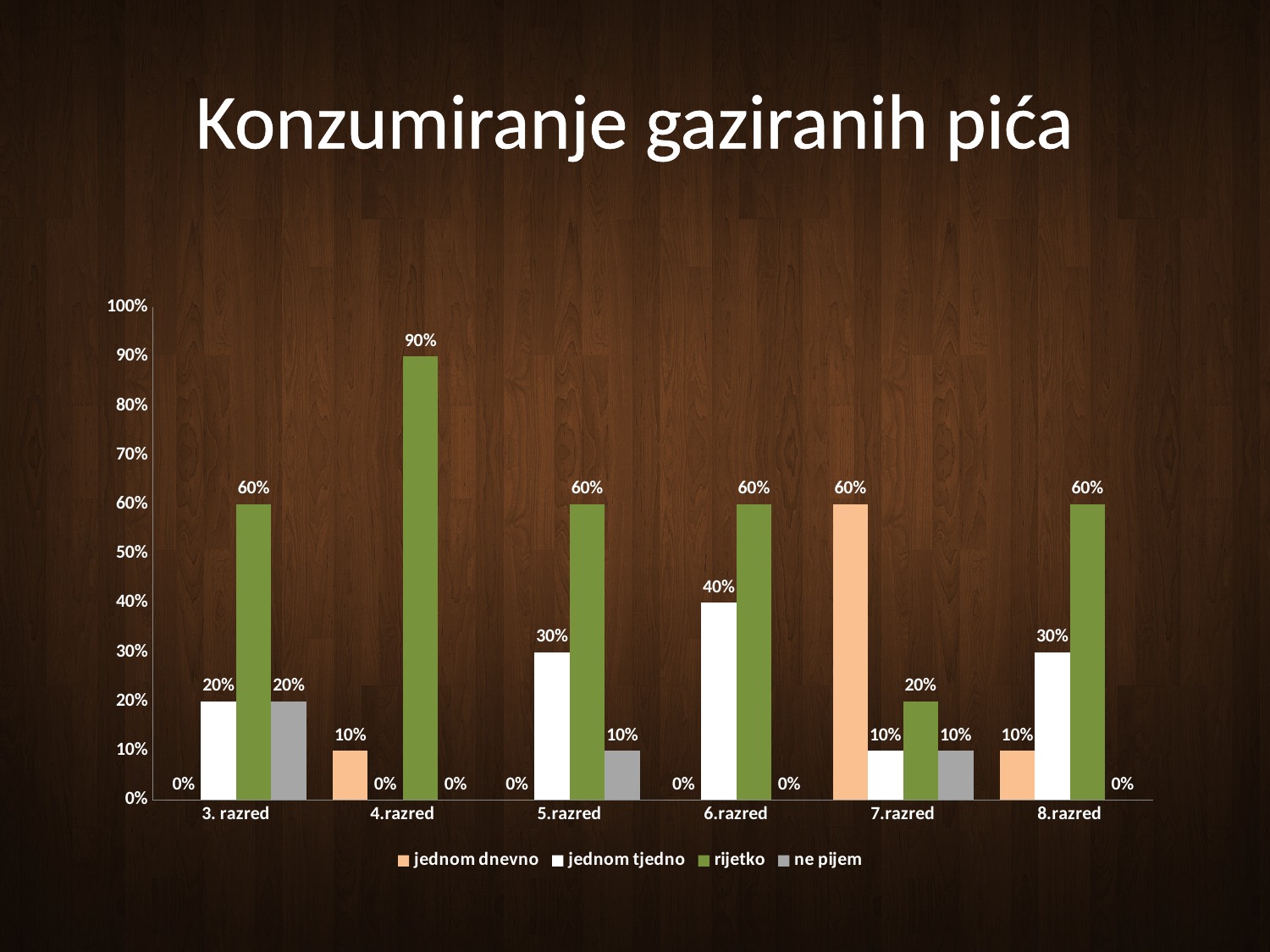
How many series does the legend list? 4 What is the value for "jednom tjedno" in 6.razred? 40% Which is larger: "jednom tjedno" in 5.razred or "jednom tjedno" in 6.razred? jednom tjedno in 6.razred Which class has the highest value for "rijetko"? 4.razred What is the value for "rijetko" in 4.razred? 90% How many classes (categories) are shown on the x axis? 6 Which class has the lowest value for "rijetko"? 7.razred What is the difference between the "rijetko" value in 4.razred and the "rijetko" value in 7.razred? 70% What is the value for "ne pijem" in 3. razred? 20% What is the title of the slide? Konzumiranje gaziranih pića What kind of chart is shown on the slide? bar chart What is the value for "jednom dnevno" in 7.razred? 60%